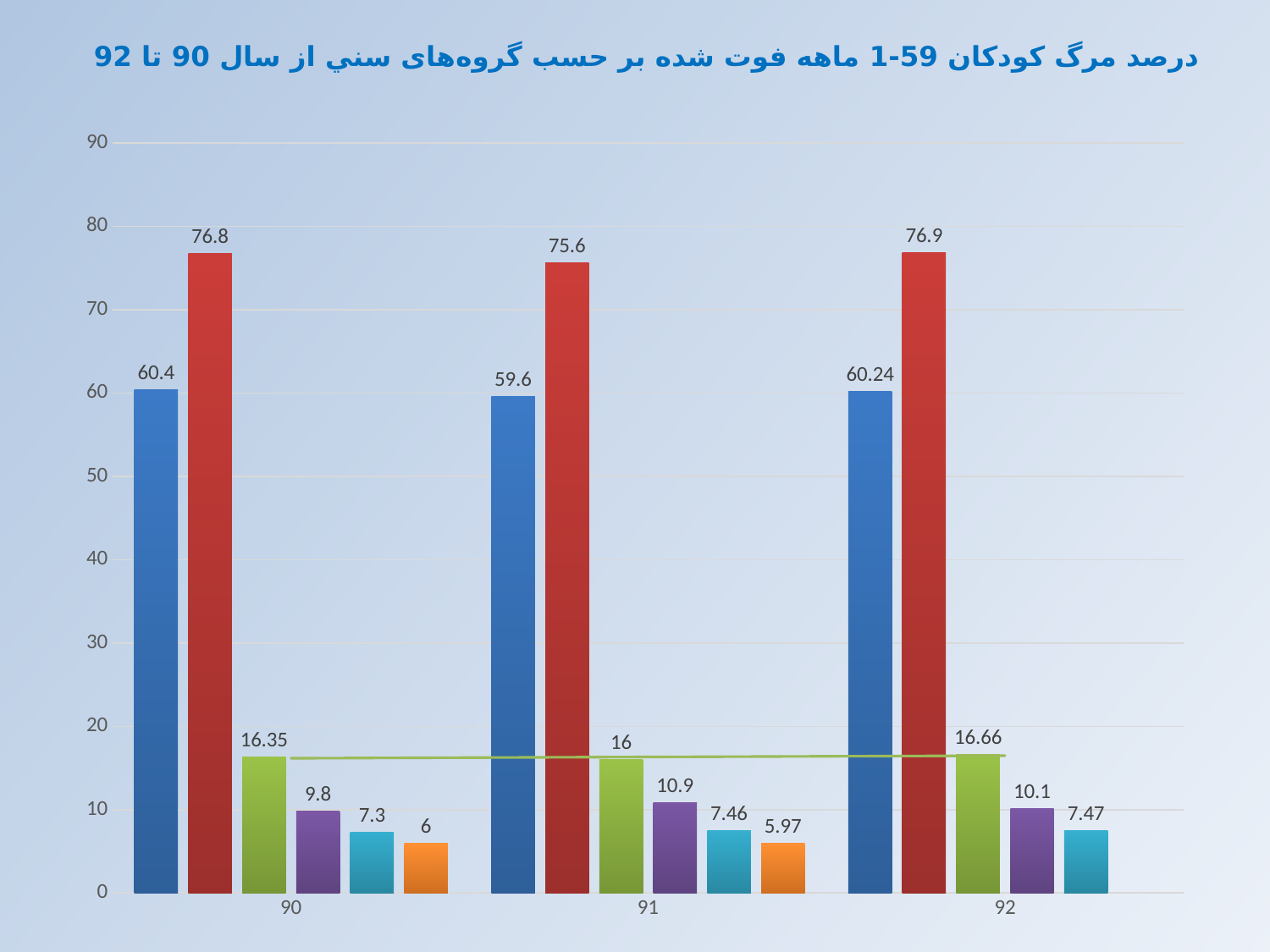
In which year is the blue bar lowest? 91 What kind of chart is this? bar chart Does the purple bar rise or fall from year 90 to year 91? rise What is the value of the orange bar for year 90? 6 What is the value of the blue bar for year 92? 60.24 Which is larger for year 92: the purple bar or the cyan bar? the purple bar What is the value of the red bar for year 90? 76.8 In which year is the red bar highest? 92 Is the value of the green bar for year 90 greater or less than 20? less What is the value of the green bar for year 91? 16 What is the difference between the red bar and the blue bar for year 91? 16 How many year categories are shown on the x axis? 3